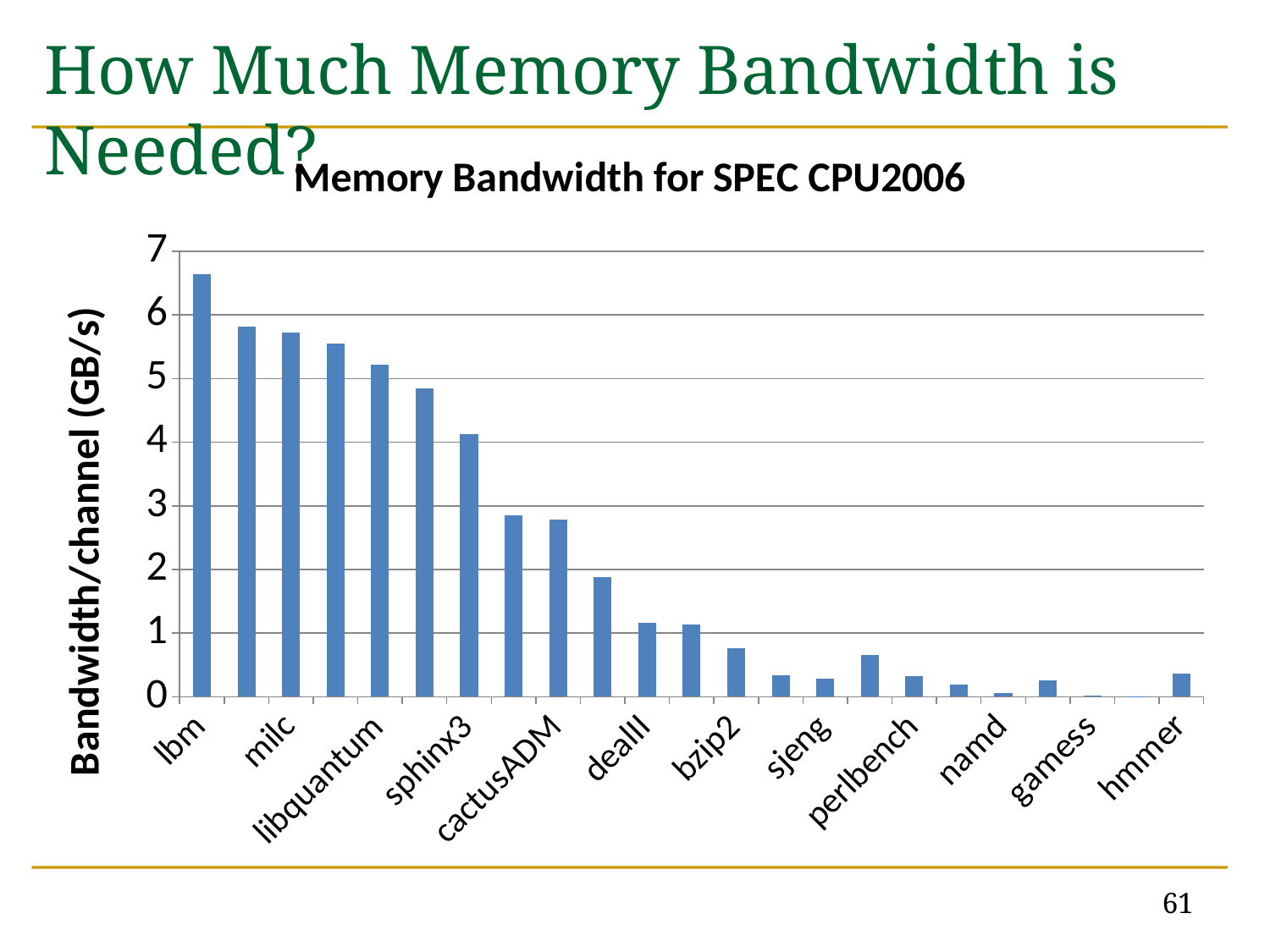
What is the label of the vertical axis? Bandwidth/channel (GB/s) Is the value for milc greater or less than 5? greater Is the value for lbm greater or less than 6? greater Which has a higher memory bandwidth, milc or dealII? milc What is the title of the chart? Memory Bandwidth for SPEC CPU2006 Which benchmark has the highest memory bandwidth? lbm What kind of chart is shown on the slide? Bar chart Is the value for hmmer greater or less than 1? less How many benchmark names are labeled on the x axis? 12 Do the bandwidth values generally rise or fall from left to right along the x axis? fall